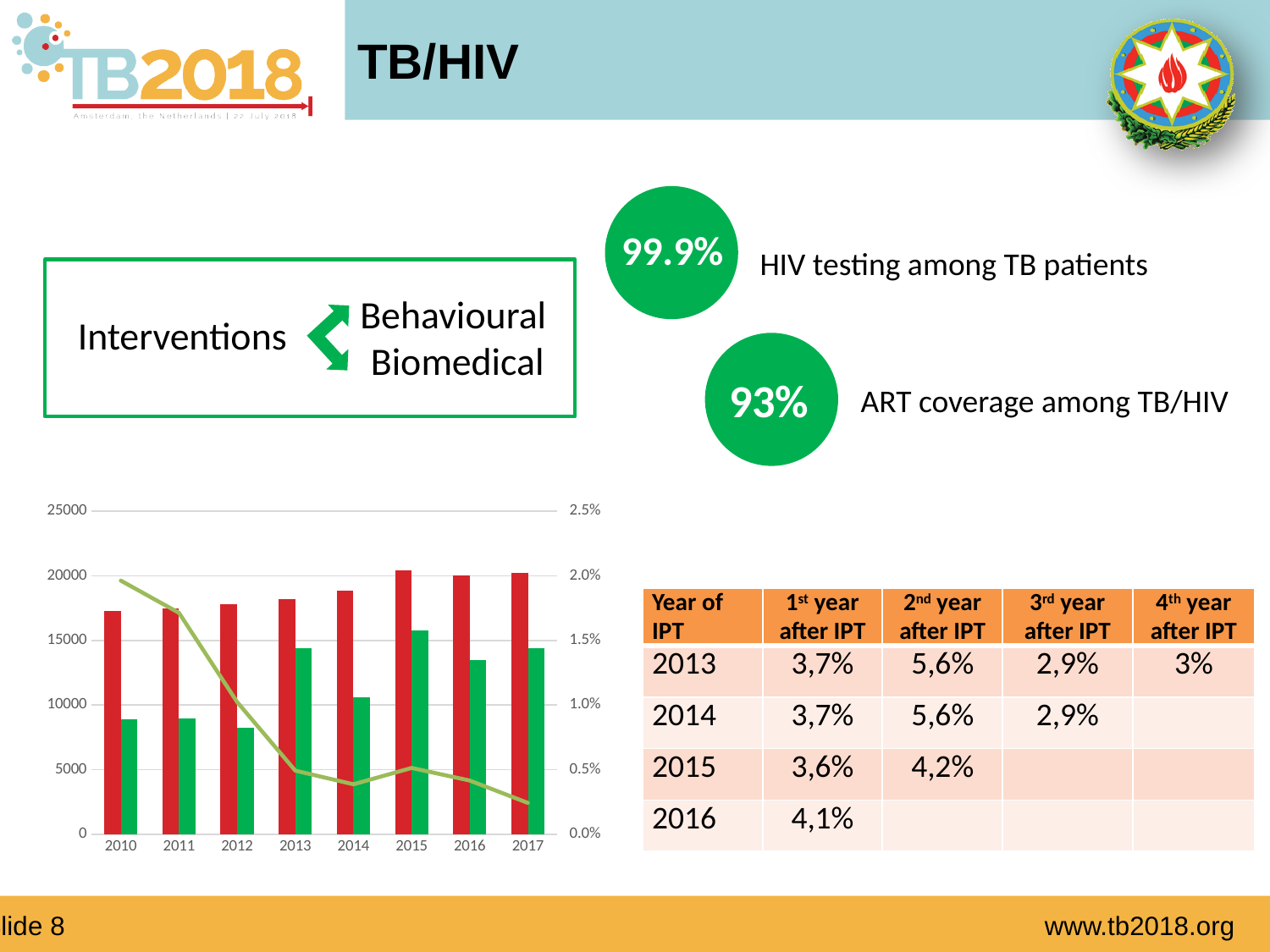
Does the green line rise or fall overall from 2010 to 2017? Fall In which year is the green line at its lowest? 2017 What kind of chart is shown at the bottom left of the slide? Bar chart with a line Is the value of the red bar for 2010 greater or less than 20000? less Is the value of the green bar for 2015 greater or less than 15000? greater In which year is the green bar highest? 2015 In 2010, which bar is taller, the red bar or the green bar? Red bar How many years are shown on the x axis of the chart? 8 Is the value of the green line for 2010 greater or less than 1.5%? greater What is the highest value shown on the right-hand axis of the chart? 2.5%